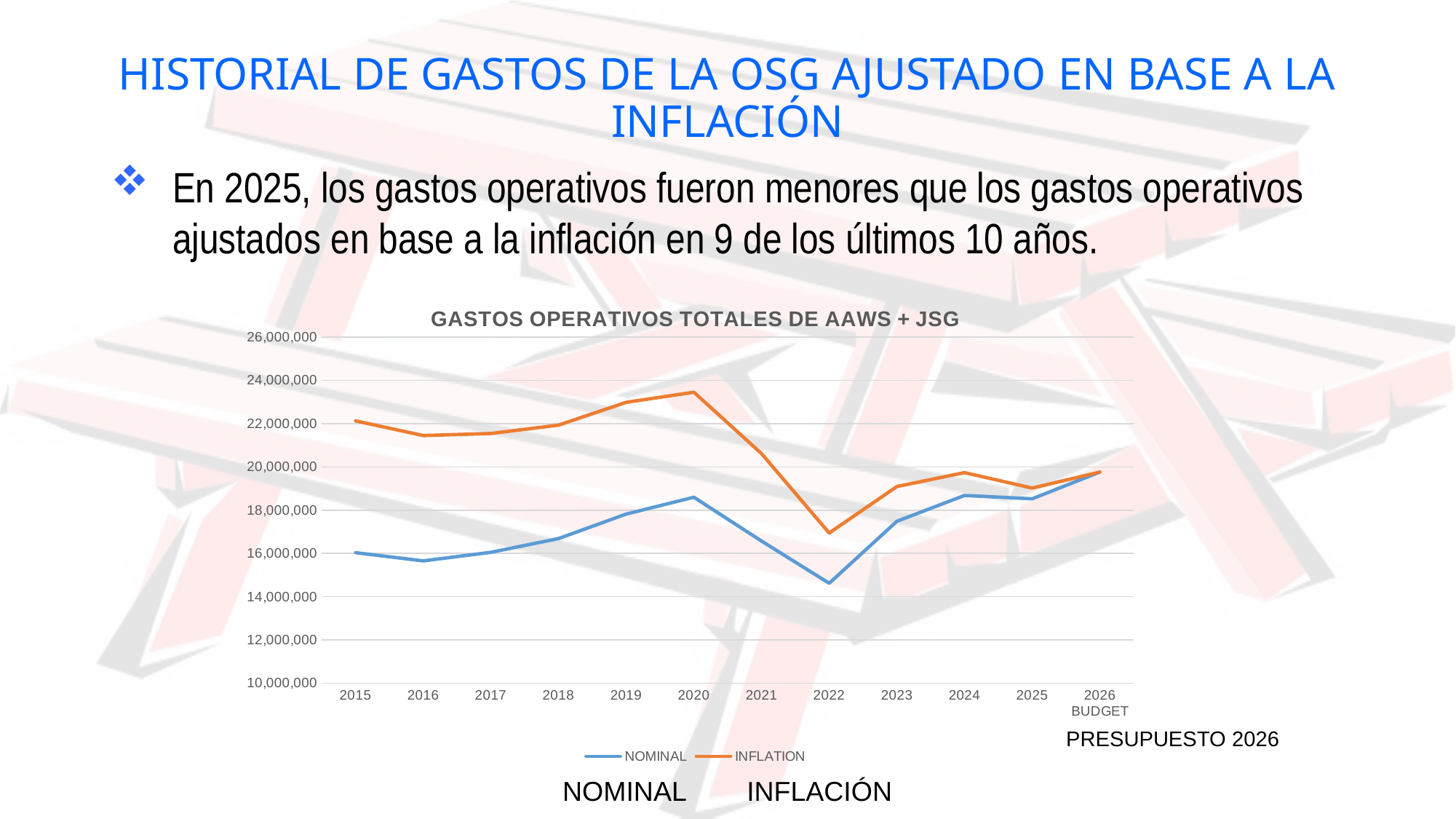
In which year does the NOMINAL series reach its lowest value? 2022 How many years (points) are shown along the x axis of the chart? 12 Is the INFLATION value for 2020 greater or less than 22,000,000? greater What kind of chart is shown on the slide? Line chart Which series is drawn in orange in the chart? INFLATION How many series does the chart legend list? 2 In 2020, which series has the larger value, NOMINAL or INFLATION? INFLATION What is the title of the chart? GASTOS OPERATIVOS TOTALES DE AAWS + JSG Does the INFLATION series rise or fall from 2020 to 2022? Fall Is the INFLATION value for 2016 greater or less than 22,000,000? less Is the NOMINAL value for 2022 greater or less than 16,000,000? less In which year does the INFLATION series reach its highest value? 2020